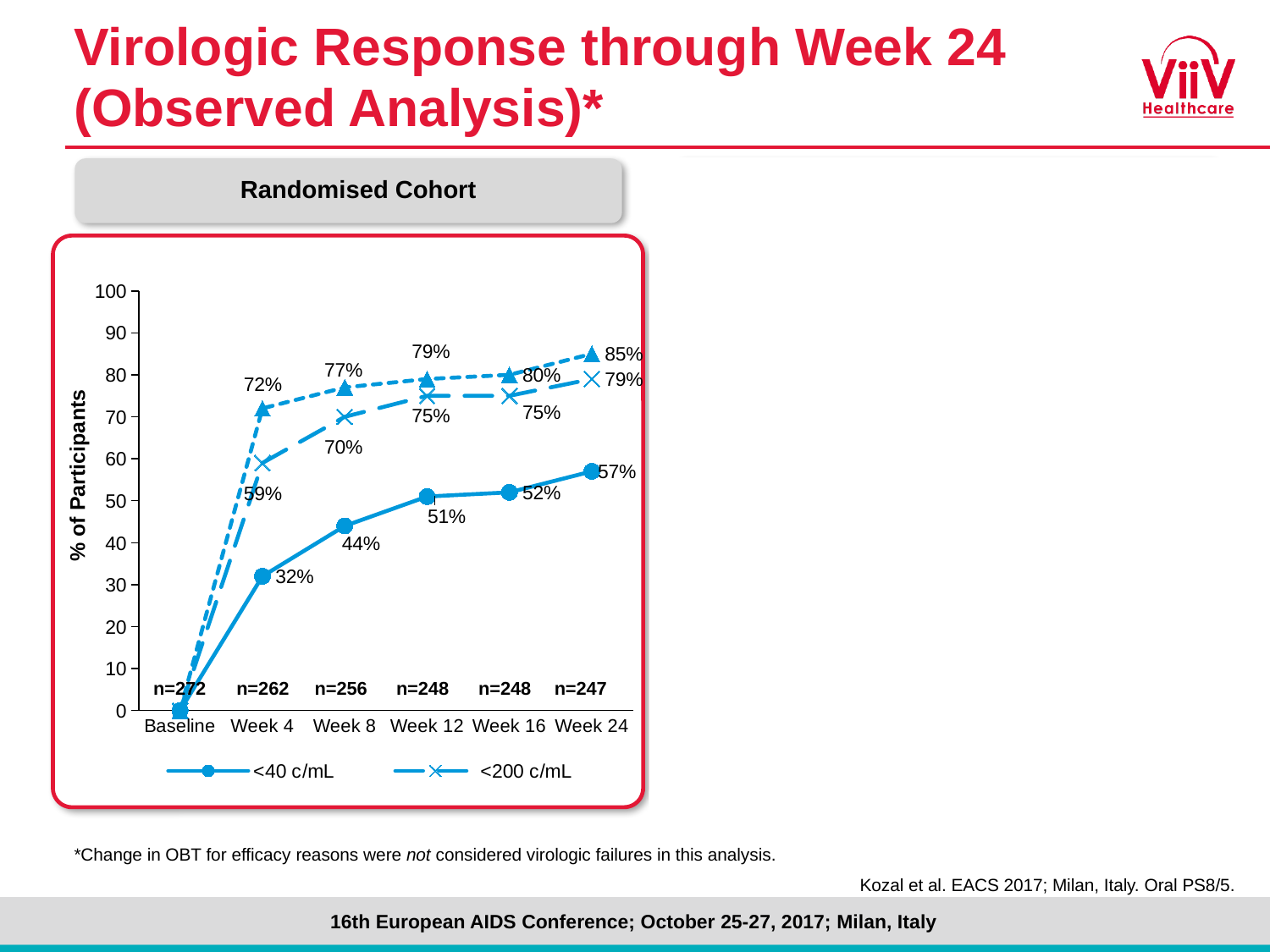
What kind of chart is shown? Line chart What is the difference between the <40 c/mL values at Week 8 and Week 4? 12% What is the difference between the <200 c/mL and <40 c/mL values at Week 24? 22% What is the value for <200 c/mL at Week 8? 70% What is the value for <40 c/mL at Week 4? 32% Which is larger at Week 12, the <40 c/mL value or the <200 c/mL value? <200 c/mL What is the value for <40 c/mL at Week 24? 57% Does the <40 c/mL series rise or fall from Baseline to Week 24? Rise How many series does the legend list? 2 At which time point is the <40 c/mL value highest? Week 24 What is the value for <200 c/mL at Week 24? 79% How many time points are shown on the x axis? 6